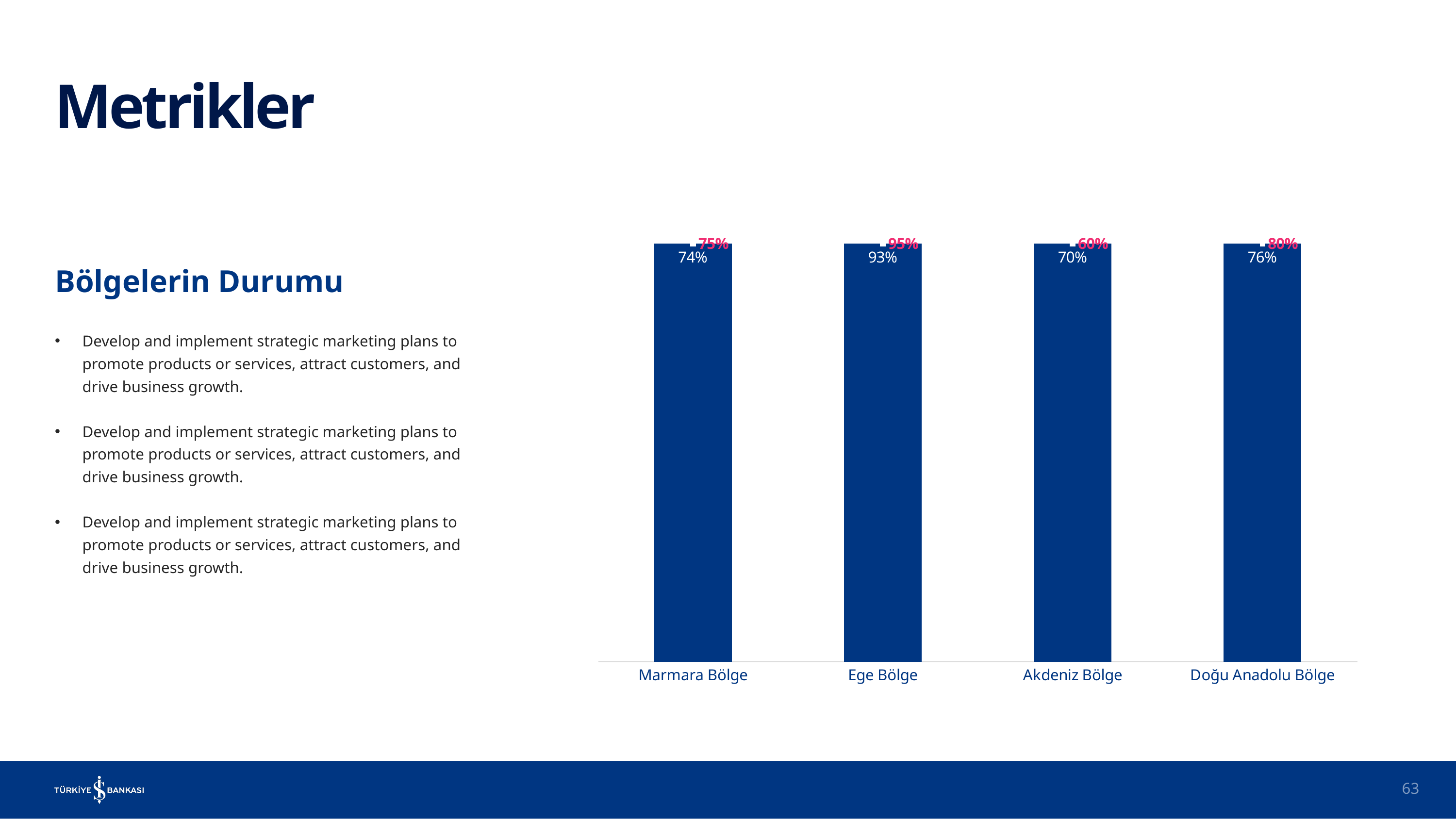
Which region has the lowest pink label value? Akdeniz Bölge What is the pink label shown at the top of the Akdeniz Bölge bar? 60% What is the difference between the white data labels of Ege Bölge (93%) and Marmara Bölge (74%)? 19 percentage points What kind of chart is shown on the slide? bar chart Which region has the lowest white data label value? Akdeniz Bölge What is the white data label shown inside the Ege Bölge bar? 93% How many regions (categories) are shown on the x axis of the chart? 4 What is the white data label shown inside the Marmara Bölge bar? 74% What is the heading shown to the left of the chart? Bölgelerin Durumu Based on the white data labels, which is larger: Doğu Anadolu Bölge or Akdeniz Bölge? Doğu Anadolu Bölge Which region has the highest white data label value? Ege Bölge What is the pink label shown at the top of the Doğu Anadolu Bölge bar? 80%